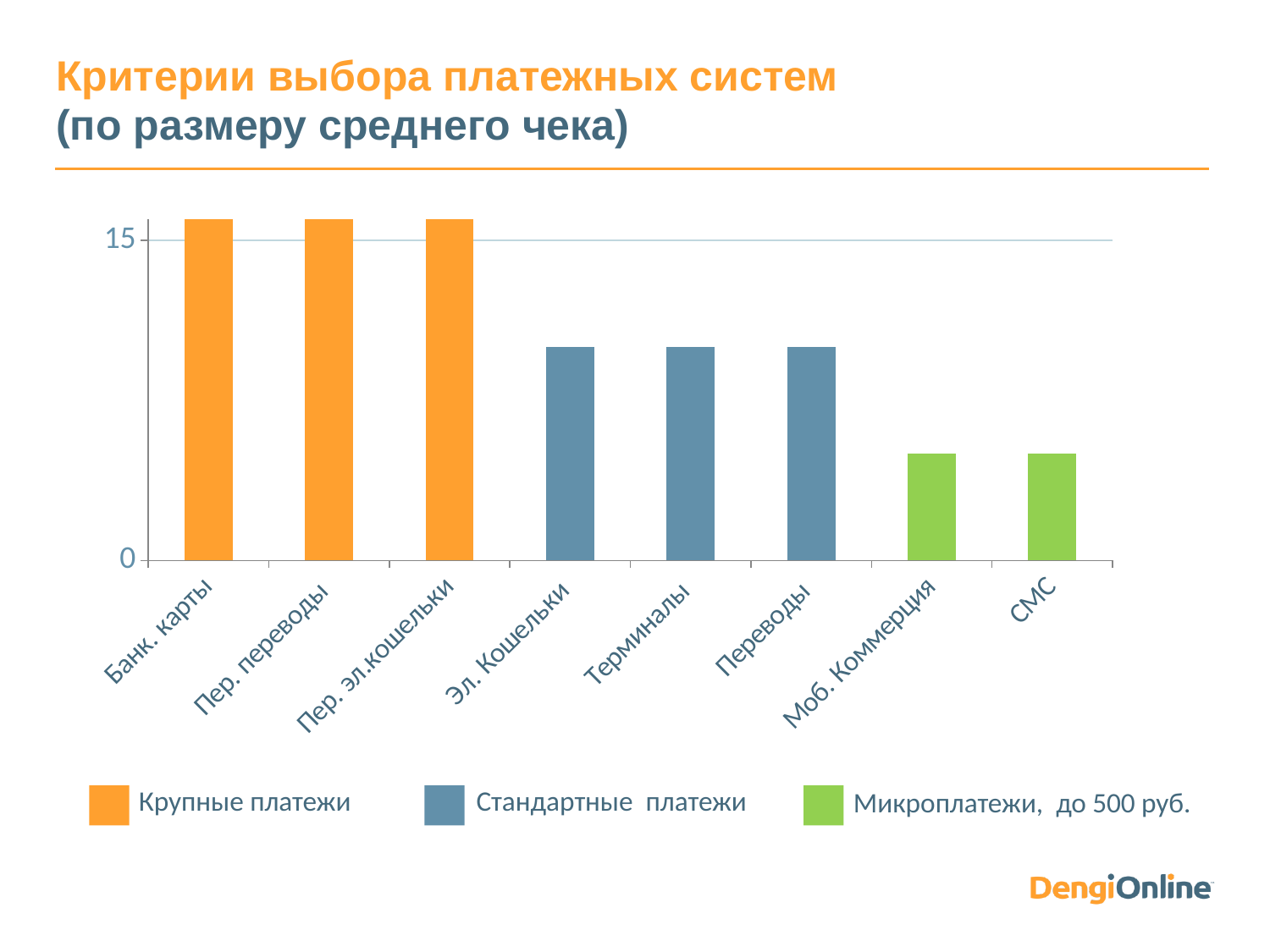
Do the bar values rise or fall from left to right along the x axis? fall What kind of chart is shown on the slide? bar chart Which is larger, the value for Переводы or the value for Моб. Коммерция? Переводы Which legend entry is shown in green? Микроплатежи, до 500 руб. Which is larger, the value for Банк. карты or the value for Эл. Кошельки? Банк. карты How many categories are shown on the x axis of the chart? 8 What is the title of the chart on the slide? Критерии выбора платежных систем (по размеру среднего чека) Is the value for Терминалы greater or less than 0? greater Which is larger, the value for СМС or the value for Пер. переводы? Пер. переводы Is the value for Эл. Кошельки greater or less than 15? less How many series does the legend list? 3 Is the value for СМС greater or less than 15? less